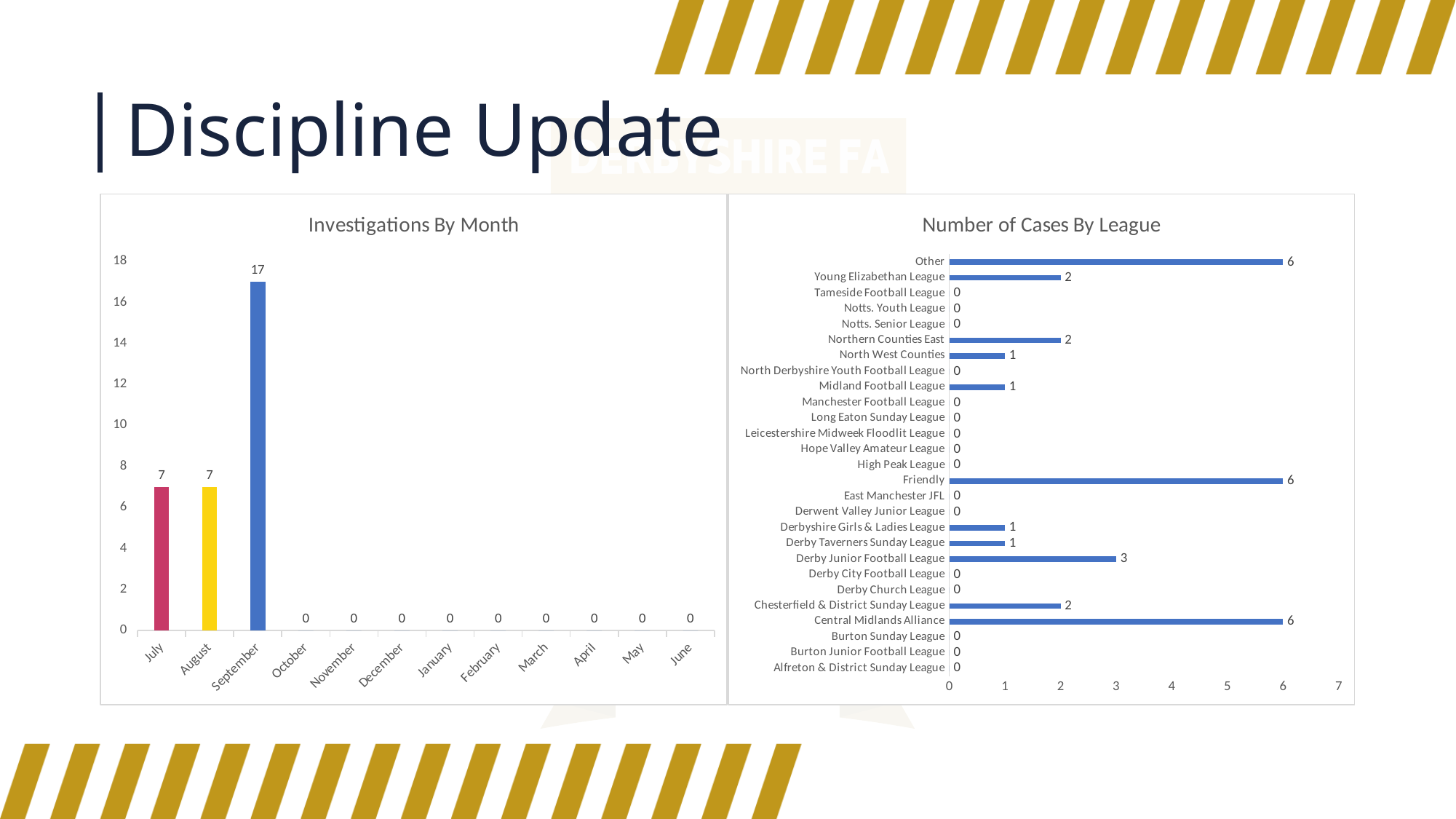
In the Investigations By Month chart, how many months are shown on the x axis? 12 In the Number of Cases By League chart, what is the difference between the Friendly value and the Young Elizabethan League value? 4 In the Number of Cases By League chart, how many cases does the Central Midlands Alliance have? 6 In the Investigations By Month chart, what is the value for October? 0 In the Investigations By Month chart, how many investigations were there in September? 17 In the Number of Cases By League chart, how many leagues are listed on the vertical axis? 27 In the Investigations By Month chart, how many investigations were there in July? 7 In the Number of Cases By League chart, how many cases does the Derby Junior Football League have? 3 What kind of chart is the Number of Cases By League chart? Bar chart In the Number of Cases By League chart, which has more cases: Northern Counties East or North West Counties? Northern Counties East In the Investigations By Month chart, what is the difference between the September and August values? 10 In the Investigations By Month chart, which month has the highest number of investigations? September